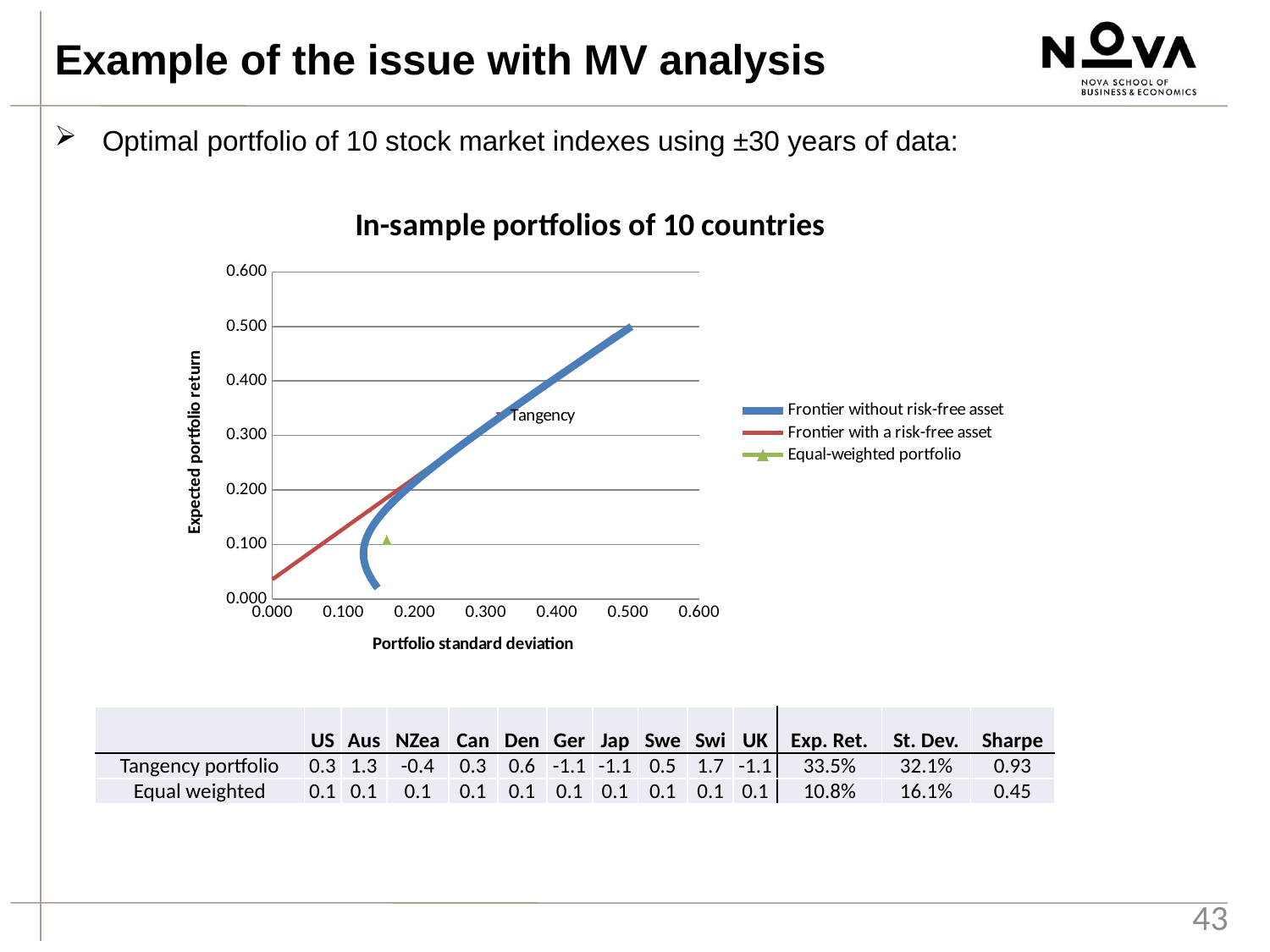
Which has the higher expected portfolio return, the Tangency point or the Equal-weighted portfolio point? Tangency Is the highest expected return reached by the 'Frontier without risk-free asset' curve greater or less than 0.400? greater Is the portfolio standard deviation of the Equal-weighted portfolio point greater or less than 0.100? greater Is the expected return of the Equal-weighted portfolio point greater or less than 0.200? less What is the label of the chart's vertical axis? Expected portfolio return Does the 'Frontier with a risk-free asset' line rise or fall as portfolio standard deviation increases? rise What kind of chart is shown on the slide? Line chart (scatter with lines) What is the title of the chart? In-sample portfolios of 10 countries How many series does the chart legend list? 3